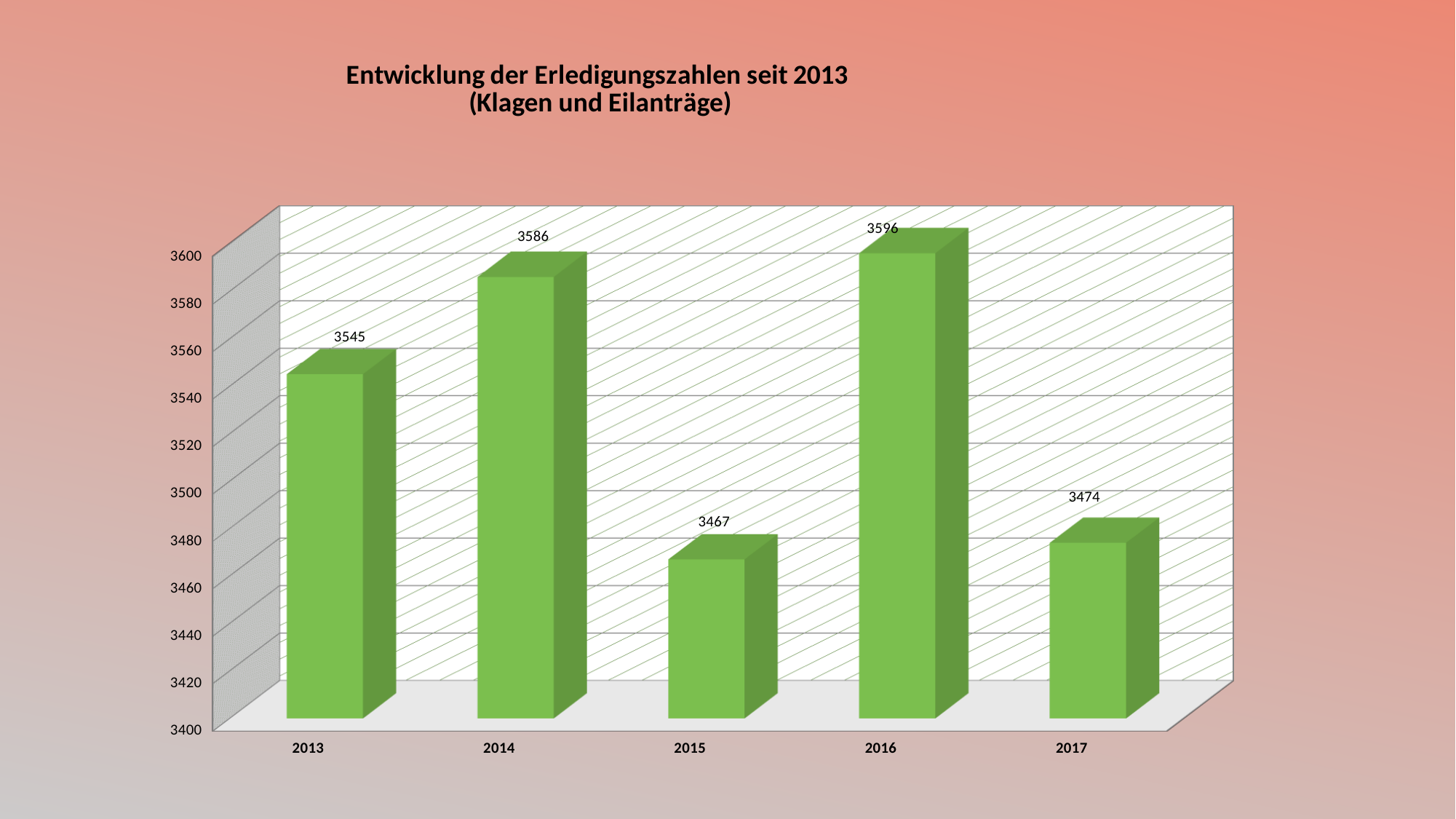
What is the value for 2015? 3467 Is the value for 2014 greater or less than 3560? greater What is the value for 2013? 3545 Which year has the lowest value? 2015 How many years are shown on the x axis? 5 What kind of chart is shown on the slide? bar chart What is the difference between the values for 2014 and 2015? 119 Which year has the highest value? 2016 What is the title of the chart? Entwicklung der Erledigungszahlen seit 2013 (Klagen und Eilanträge) What is the difference between the values for 2016 and 2014? 10 What is the value for 2017? 3474 Which is larger, the value for 2013 or the value for 2017? 2013